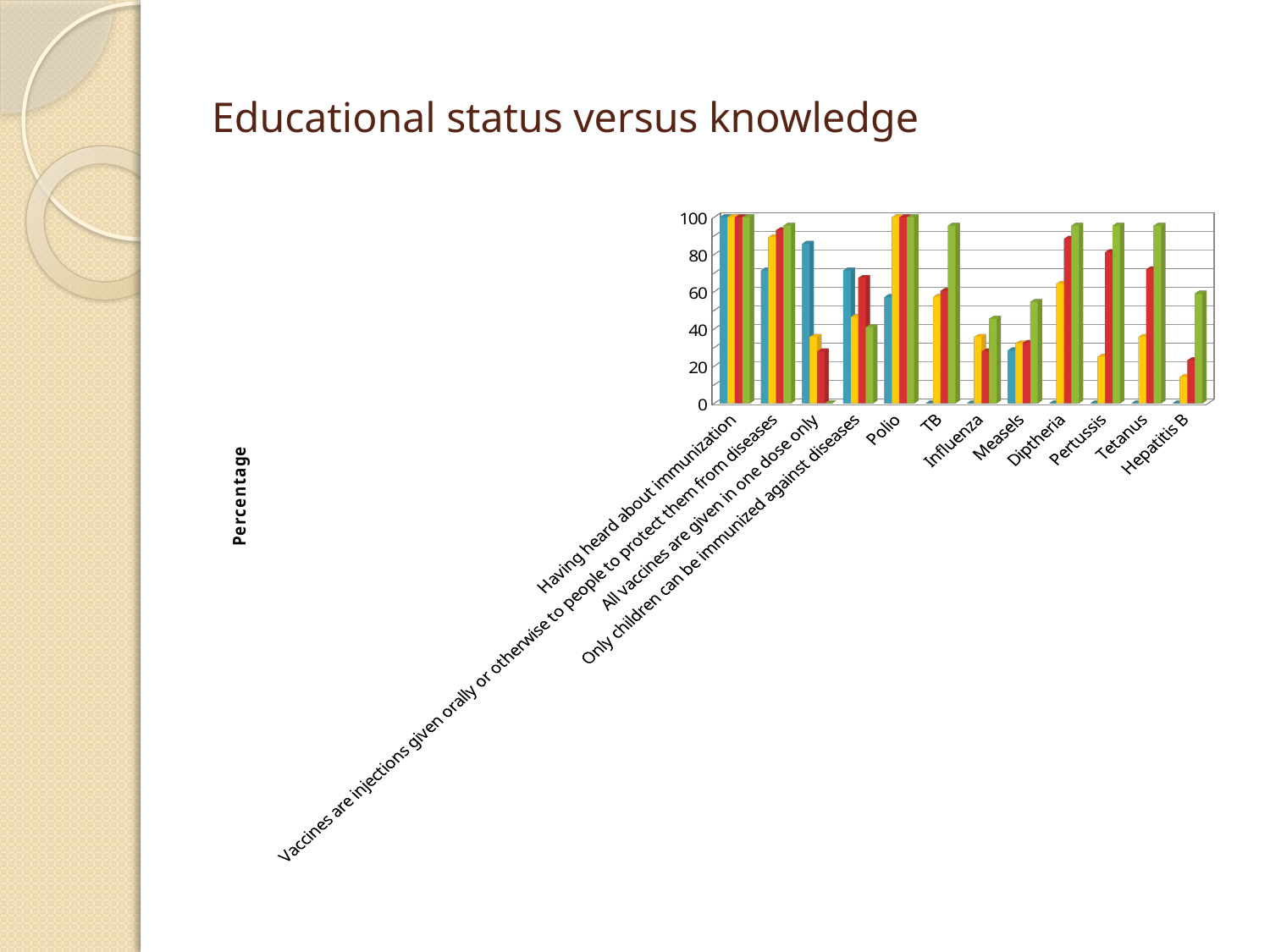
Is the value of the green bar for Hepatitis B greater or less than 40? greater Is the value of the yellow bar for Hepatitis B greater or less than 20? less Is the value of the blue bar for Measels greater or less than 40? less What is the title of the slide containing the chart? Educational status versus knowledge Which coloured bar is the tallest for Hepatitis B? green Which is larger: the red bar for Diptheria or the red bar for Tetanus? Diptheria What kind of chart is shown on the slide? bar chart Which coloured bar is the shortest for Hepatitis B? yellow What is the label on the vertical axis of the chart? Percentage How many categories are shown along the x axis of the chart? 12